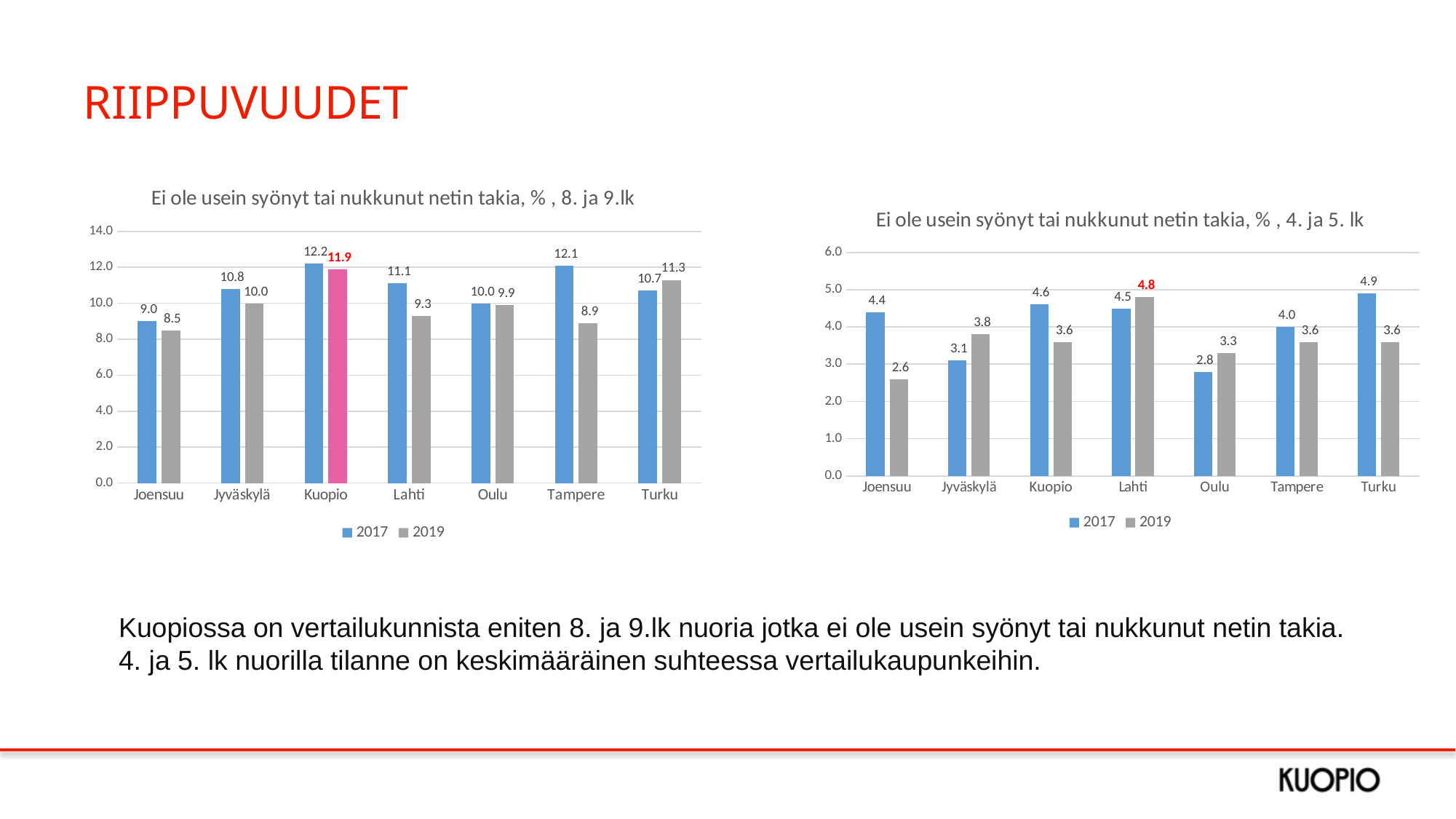
In the left chart (8. ja 9.lk), which city has the highest 2017 value? Kuopio How many cities are shown on the x axis of the right chart (4. ja 5. lk)? 7 In the right chart (4. ja 5. lk), what is the difference between the 2017 and 2019 values for Joensuu? 1.8 In the right chart (4. ja 5. lk), which city has the highest 2017 value? Turku In the left chart (8. ja 9.lk), is the 2019 value for Turku larger than the 2017 value for Turku? Yes In the left chart (8. ja 9.lk), which city has the lowest 2019 value? Joensuu In the left chart (8. ja 9.lk), what is the 2019 value for Kuopio? 11.9 In the right chart (4. ja 5. lk), which city has the lowest 2019 value? Joensuu In the left chart (8. ja 9.lk), what is the difference between the 2017 and 2019 values for Tampere? 3.2 In the right chart (4. ja 5. lk), what is the 2019 value for Lahti? 4.8 How many series does the legend of the left chart (8. ja 9.lk) list? 2 In the left chart (8. ja 9.lk), what is the 2017 value for Tampere? 12.1